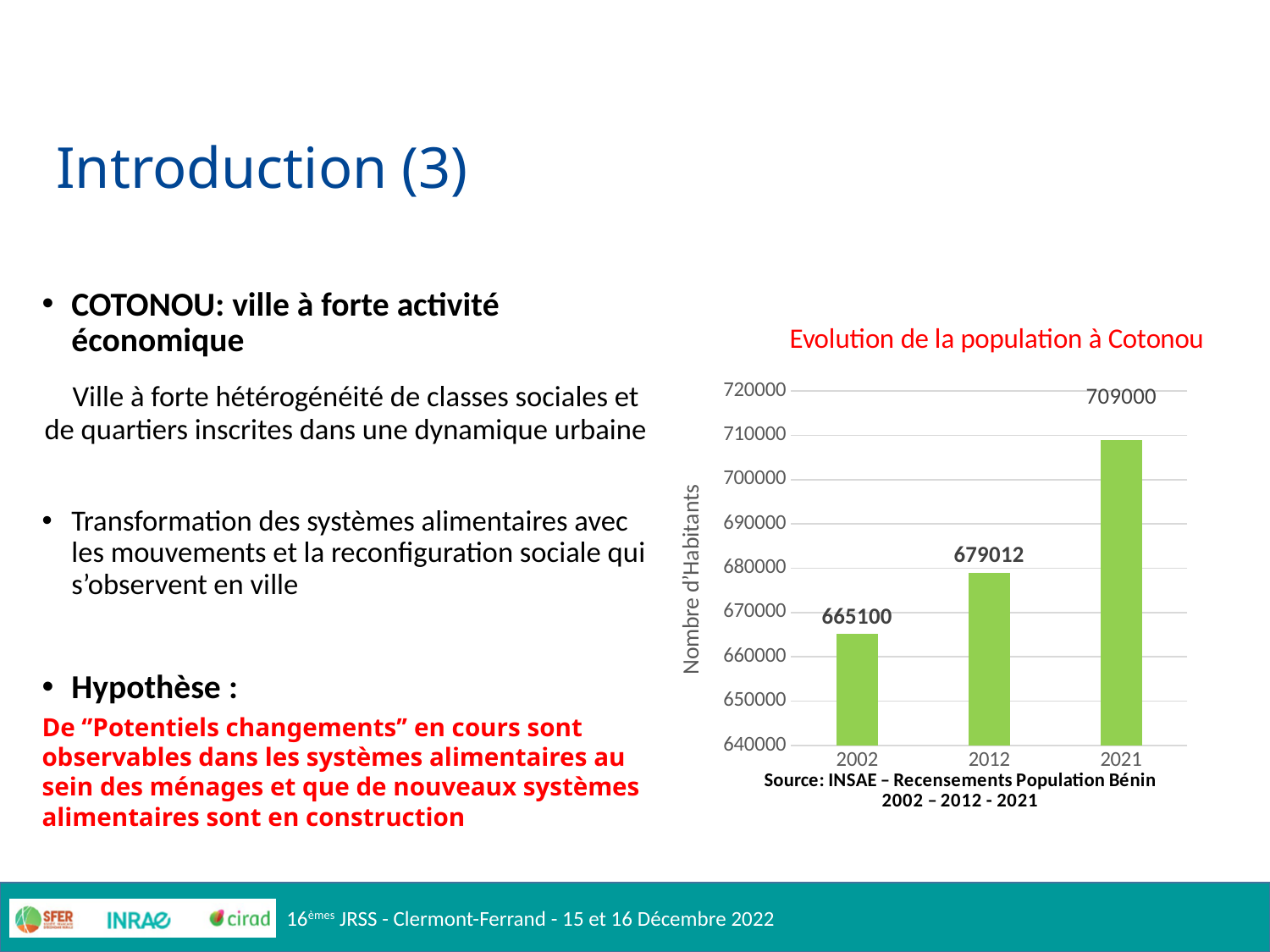
Which is larger, the population value for 2012 or for 2002? 2012 Which year has the highest population value? 2021 What is the title of the chart? Evolution de la population à Cotonou What is the difference between the population values for 2012 and 2002? 13912 What kind of chart is used to show the population of Cotonou? bar chart Which year has the lowest population value? 2002 What is the difference between the population values for 2021 and 2012? 29988 What is the population value shown for 2021? 709000 What is the population value shown for 2012? 679012 Do the population values rise or fall from 2002 to 2021? rise How many years are shown on the x axis of the chart? 3 What is the population value shown for 2002? 665100